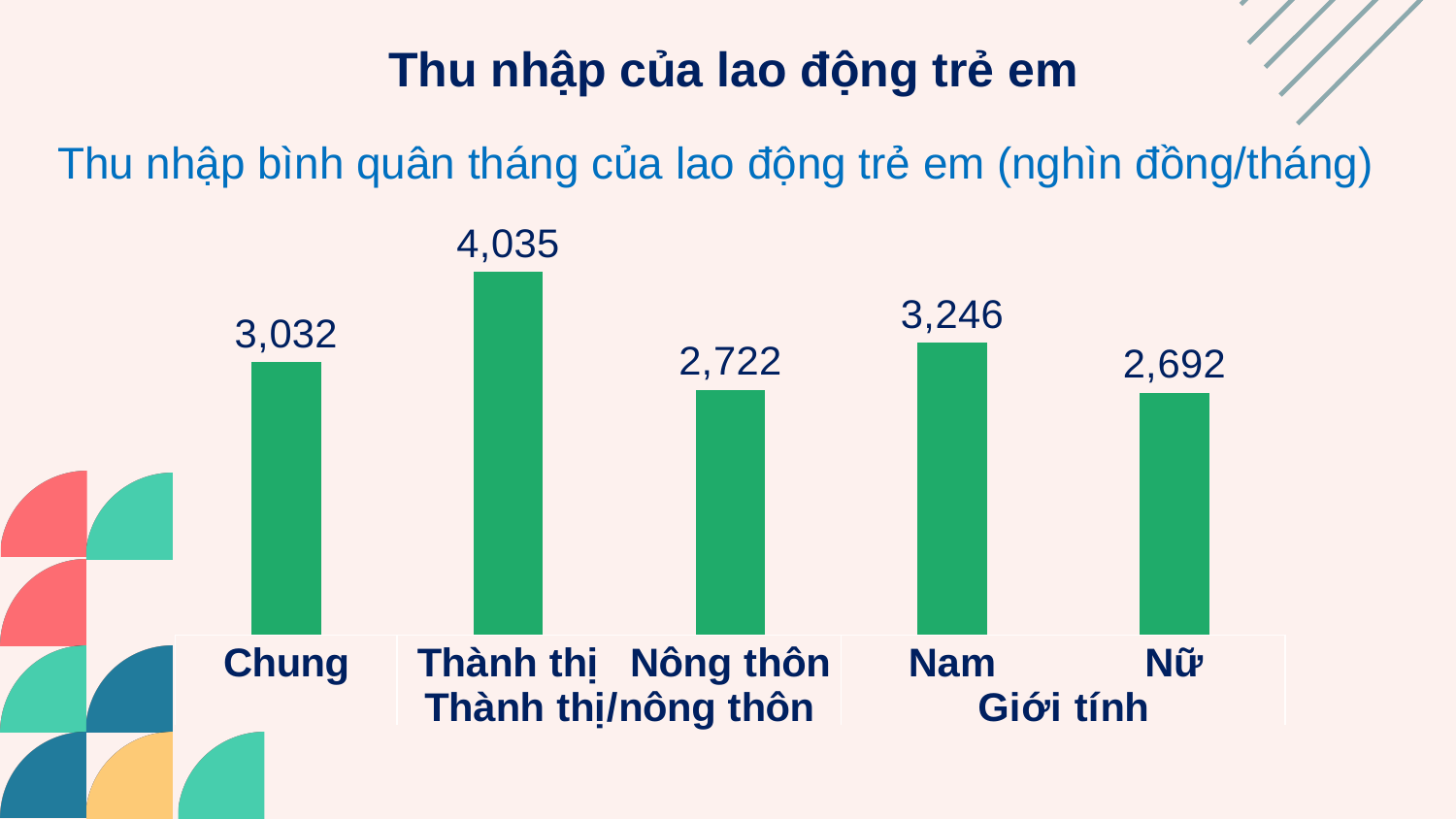
What is the chart's subtitle? Thu nhập bình quân tháng của lao động trẻ em (nghìn đồng/tháng) What is the difference between the values for Nam and Nữ? 554 What is the value shown for Nông thôn? 2,722 What kind of chart is this? Bar chart What is the difference between the values for Thành thị and Nông thôn? 1,313 Which is larger, the value for Nam or the value for Chung? Nam Which category has the highest value? Thành thị Which category has the lowest value? Nữ What is the value shown for Thành thị? 4,035 What is the average monthly income for Chung? 3,032 What is the value shown for Nữ? 2,692 How many categories are shown in the chart? 5